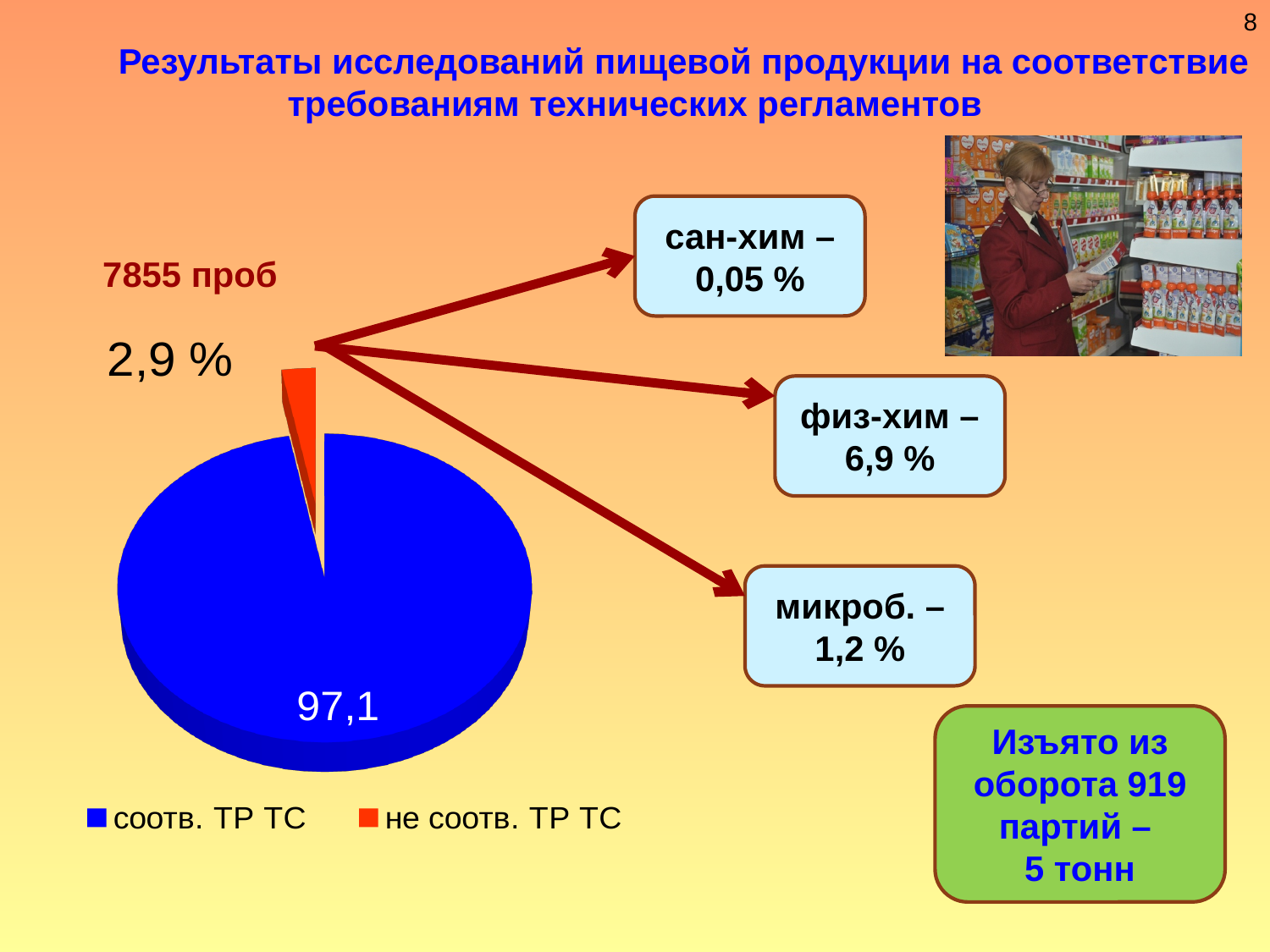
How many entries does the legend of the pie chart list? 2 Which slice of the pie chart is the smallest? не соотв. ТР ТС What value is shown for the "не соотв. ТР ТС" slice of the pie chart? 2,9 % What colour is the "не соотв. ТР ТС" slice in the pie chart? red What colour is the "соотв. ТР ТС" slice in the pie chart? blue Which slice of the pie chart is the largest? соотв. ТР ТС What kind of chart is shown on the slide? pie chart What value is shown for the "соотв. ТР ТС" slice of the pie chart? 97,1 What share of the pie does the "не соотв. ТР ТС" slice represent? 2,9 % How many slices does the pie chart have? 2 Which is larger in the pie chart: "соотв. ТР ТС" or "не соотв. ТР ТС"? соотв. ТР ТС What is the difference between the "соотв. ТР ТС" value and the "не соотв. ТР ТС" value in the pie chart? 94,2